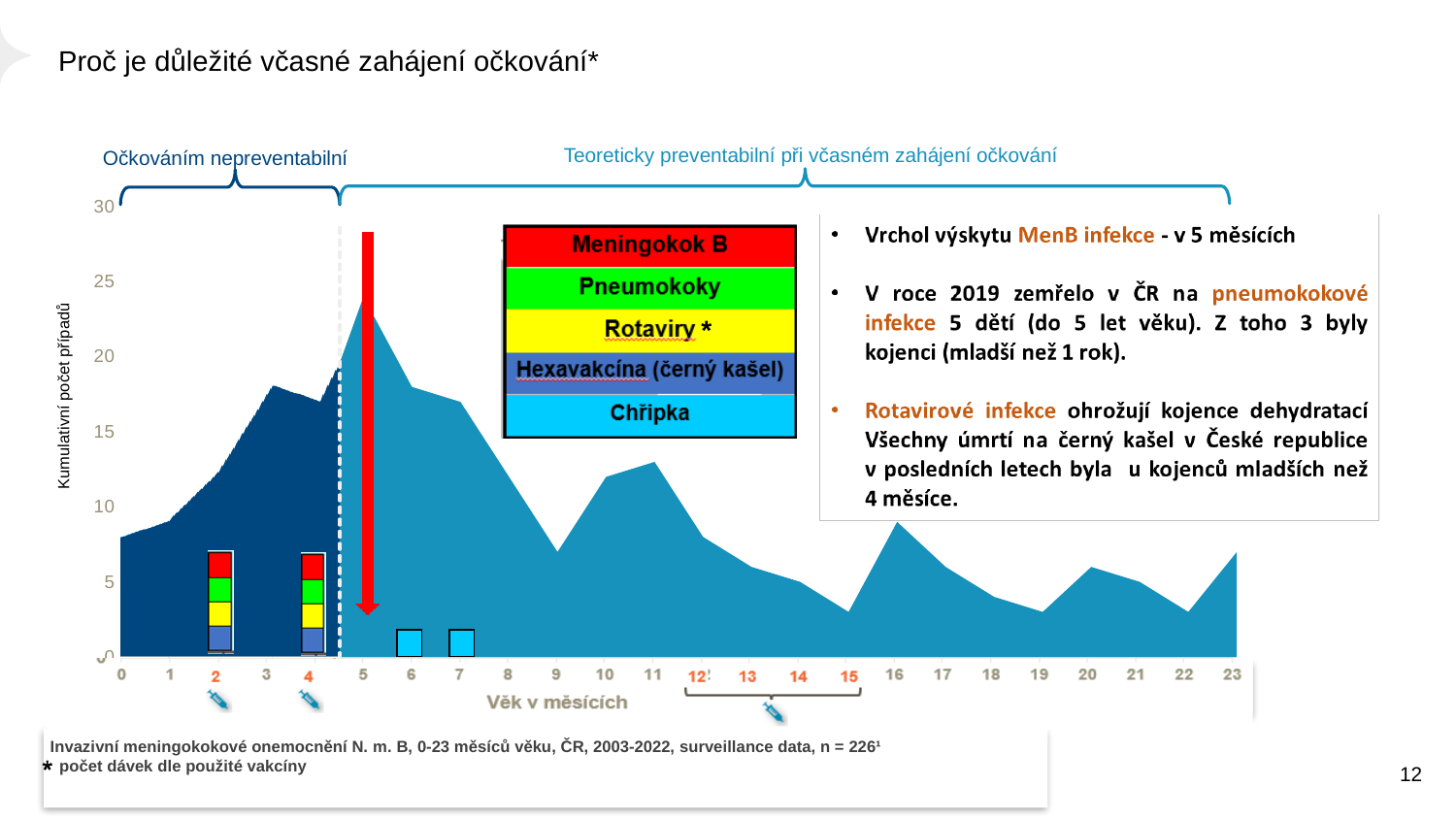
Do the values rise or fall between 5 and 9 months? fall Is the value at 5 months greater or less than 20? greater What kind of chart is shown on the slide? area chart What is the label of the y axis? Kumulativní počet případů Is the value at 11 months greater or less than 10? greater What is the label of the x axis? Věk v měsících Which is larger, the value at 3 months or the value at 9 months? 3 months How many age points (months) are shown on the x axis? 24 At which age in months does the cumulative number of cases reach its peak? 5 Is the value at 3 months greater or less than 15? greater